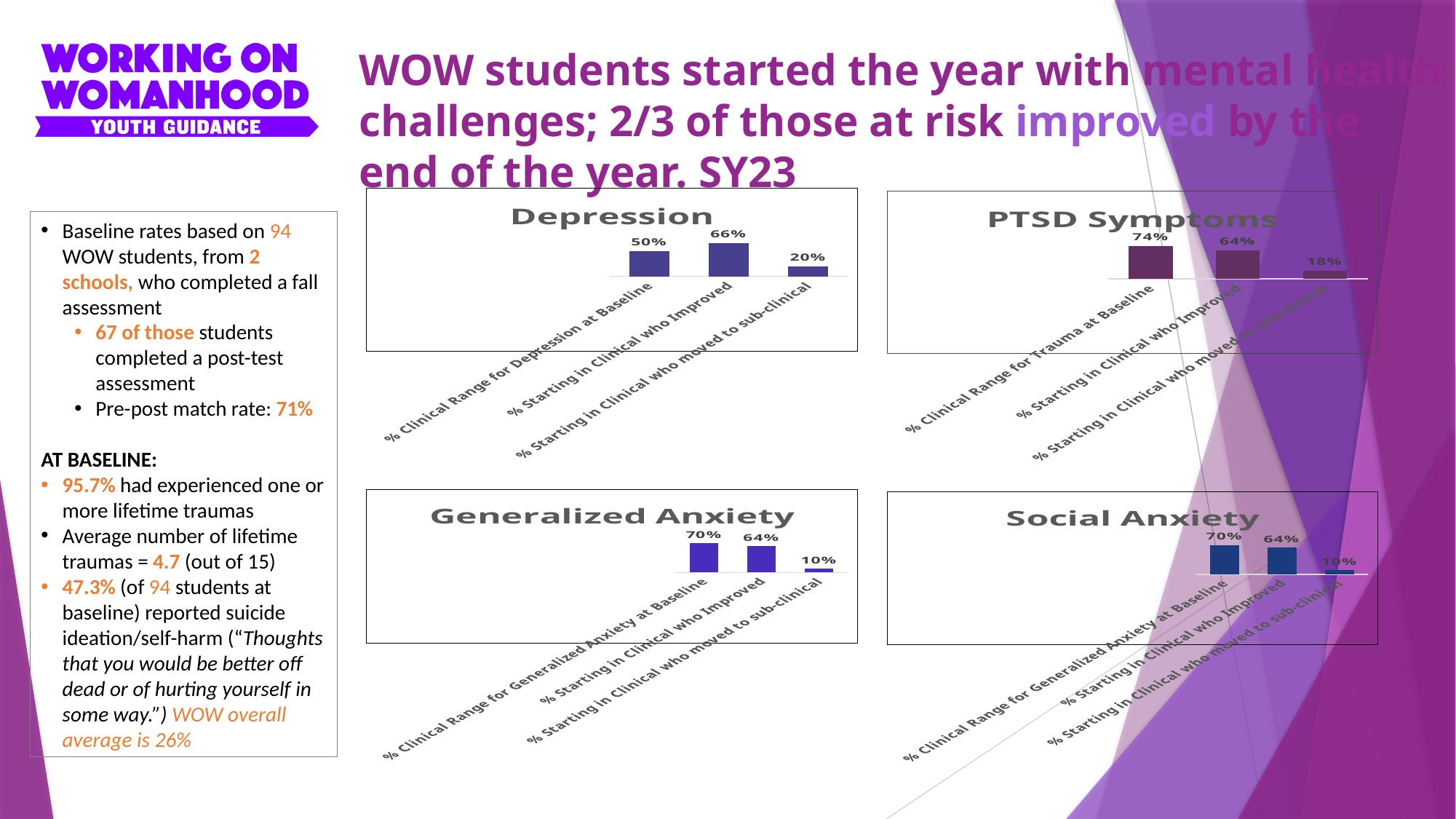
In the Generalized Anxiety chart, what is the value for % Starting in Clinical who moved to sub-clinical? 10% In the Depression chart, which is larger: the value for % Clinical Range for Depression at Baseline or the value for % Starting in Clinical who Improved? % Starting in Clinical who Improved In the PTSD Symptoms chart, which category has the lowest value? % Starting in Clinical who moved to sub-clinical In the Depression chart, what is the value for % Clinical Range for Depression at Baseline? 50% In the PTSD Symptoms chart, what is the value for % Starting in Clinical who moved to sub-clinical? 18% In the Depression chart, which category has the highest value? % Starting in Clinical who Improved In the Generalized Anxiety chart, what is the difference between the baseline clinical range value and the value for those who moved to sub-clinical? 60% How many bars are shown in the PTSD Symptoms chart? 3 In the Social Anxiety chart, what is the value for % Starting in Clinical who Improved? 64% In the Depression chart, what is the value for % Starting in Clinical who Improved? 66% What type of chart is the Social Anxiety chart? Bar chart In the PTSD Symptoms chart, what is the value for % Clinical Range for Trauma at Baseline? 74%